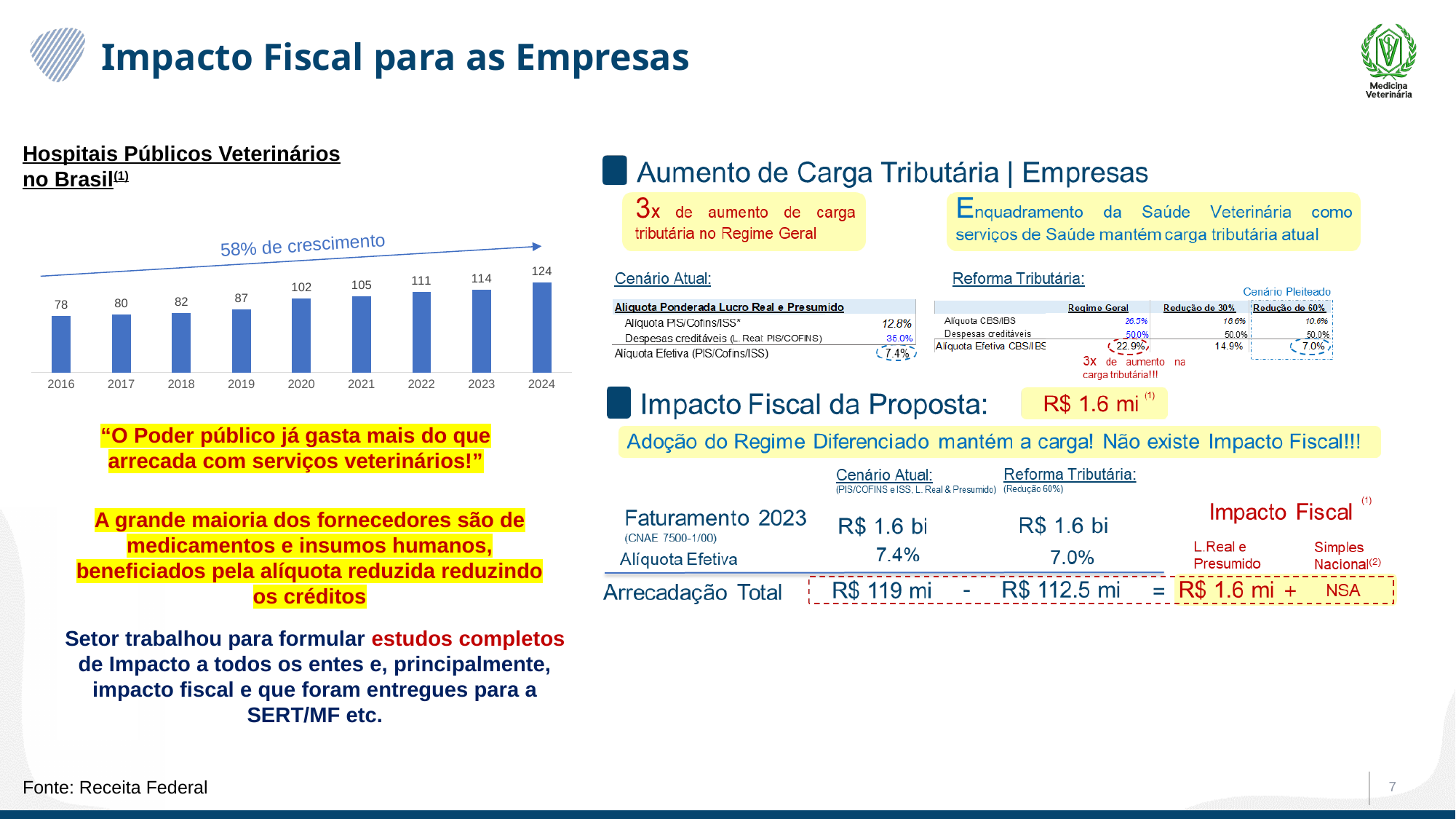
Do the values in the Hospitais Públicos Veterinários no Brasil chart rise or fall from 2016 to 2024? Rise What growth percentage is annotated above the bars in the Hospitais Públicos Veterinários no Brasil chart? 58% de crescimento How many years are shown in the Hospitais Públicos Veterinários no Brasil chart? 9 What is the difference between the 2024 and 2016 values in the Hospitais Públicos Veterinários no Brasil chart? 46 What is the value for 2024 in the Hospitais Públicos Veterinários no Brasil chart? 124 Which year has the lowest value in the Hospitais Públicos Veterinários no Brasil chart? 2016 In the Hospitais Públicos Veterinários no Brasil chart, which is larger, the value for 2022 or the value for 2021? 2022 What kind of chart is the Hospitais Públicos Veterinários no Brasil chart? Bar chart Which year has the highest value in the Hospitais Públicos Veterinários no Brasil chart? 2024 What is the difference between the 2020 and 2019 values in the Hospitais Públicos Veterinários no Brasil chart? 15 What is the value for 2016 in the Hospitais Públicos Veterinários no Brasil chart? 78 What is the value for 2020 in the Hospitais Públicos Veterinários no Brasil chart? 102